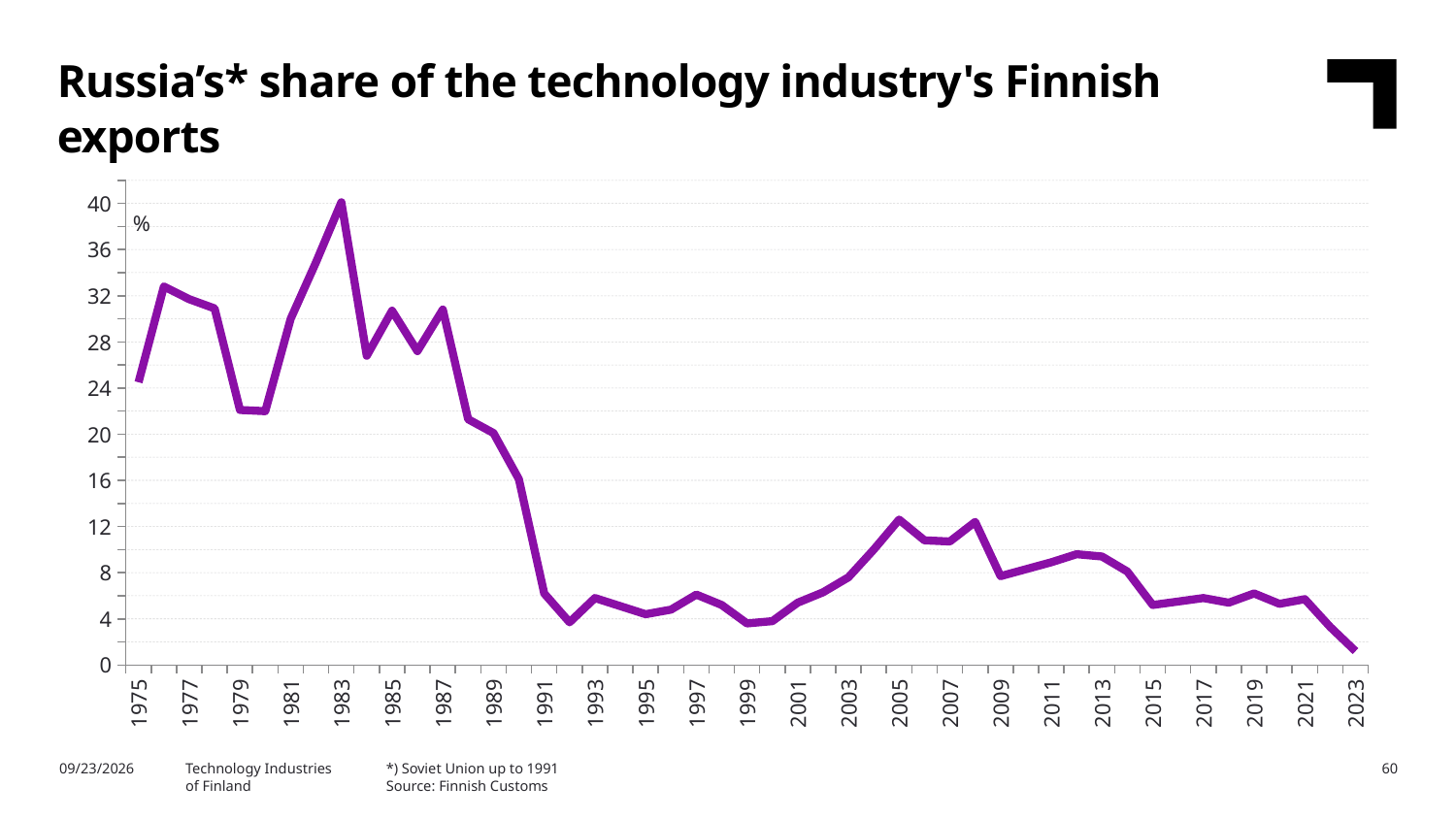
In which year does Russia's share of the technology industry's Finnish exports reach its highest value? 1983 Is the value for 1989 greater or less than 16? greater Overall, does Russia's share rise or fall from 1975 to 2023? Fall Which year has the larger value, 2005 or 2015? 2005 Is the value for 2009 greater or less than 12? less According to the footnote, which entity does the series refer to up to 1991? Soviet Union Is the value for 2023 greater or less than 4? less What kind of chart is shown on the slide? Line chart In which year is Russia's share of the technology industry's Finnish exports at its lowest? 2023 Which year has the larger value, 1983 or 1985? 1983